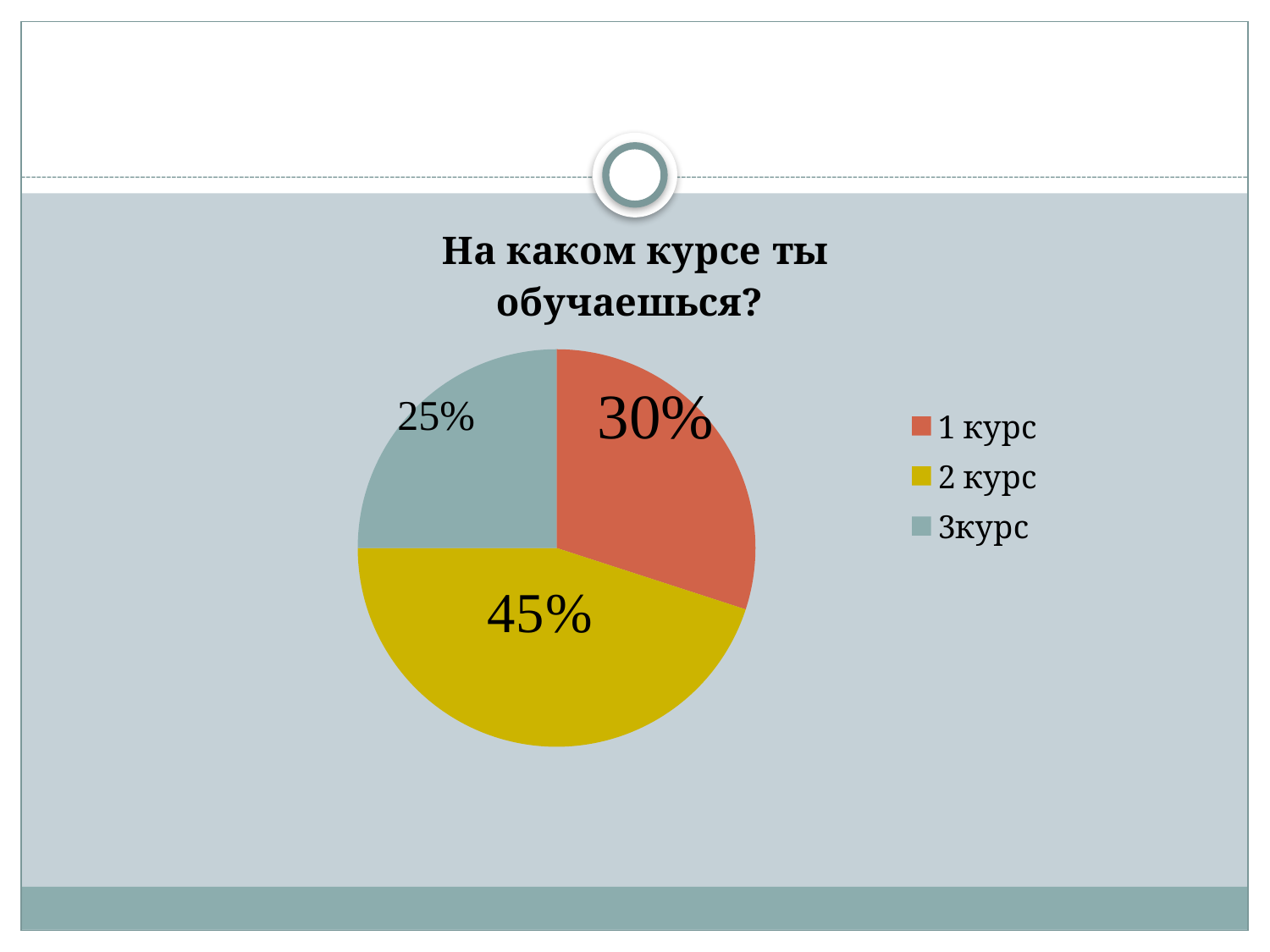
How many categories does the pie chart have? 3 What type of chart is shown on the slide? pie chart What is the difference between the shares of "1 курс" and "3курс"? 5% What share of the pie does "2 курс" have? 45% What is the title of the chart? На каком курсе ты обучаешься? What share of the pie does "3курс" have? 25% What is the difference between the shares of "2 курс" and "1 курс"? 15% Which category has the largest slice of the pie? 2 курс Which is larger, the share for "1 курс" or the share for "3курс"? 1 курс Which category has the smallest slice of the pie? 3курс What share of the pie does "1 курс" have? 30% What colour is the slice for "2 курс"? yellow